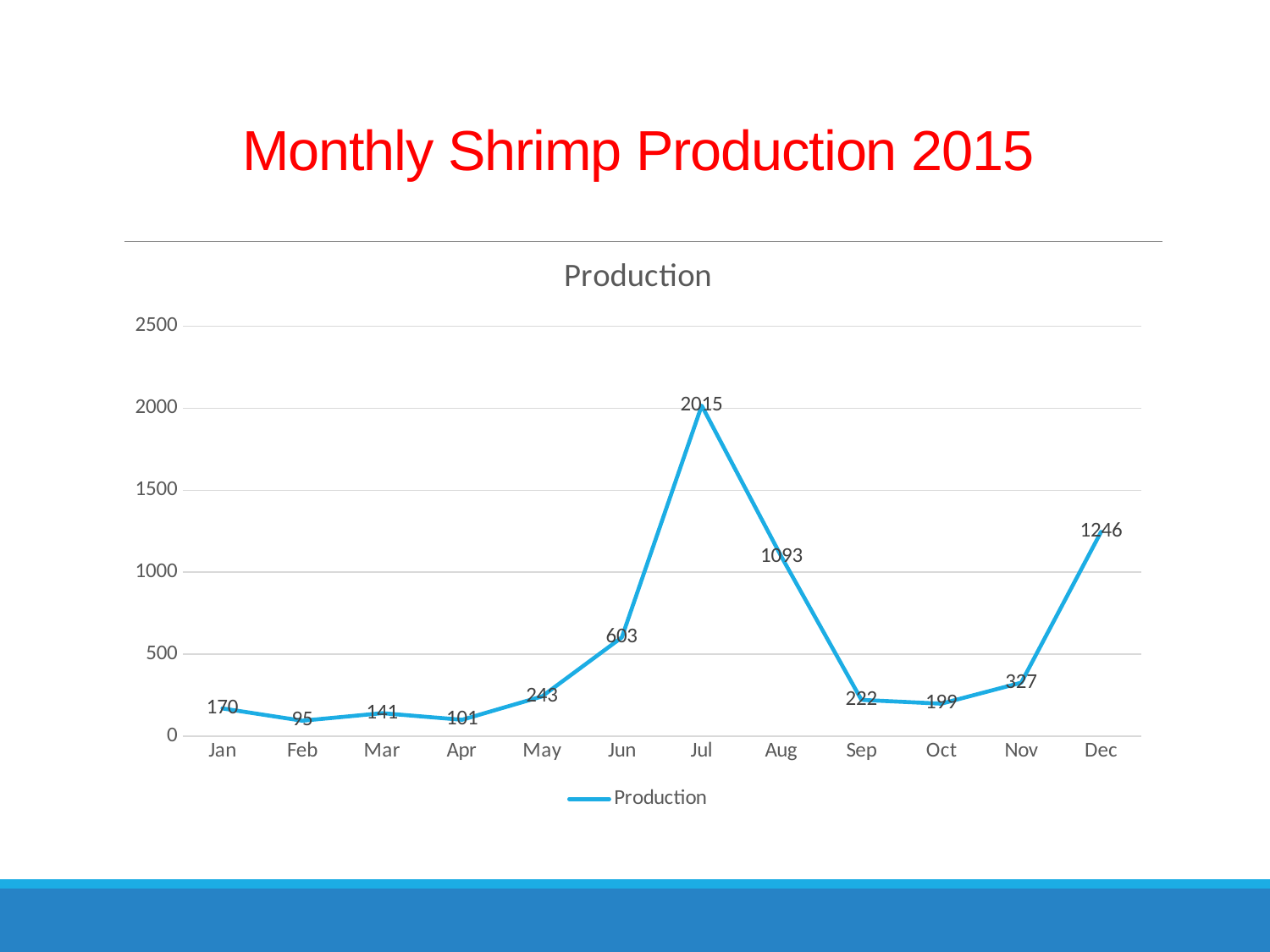
What is the difference between the production in July and in August? 922 What kind of chart is shown on the slide? line chart What is the production value for December? 1246 Which month has the lowest production? Feb How many months are plotted on the x axis? 12 How many series does the legend list? 1 What is the production value for February? 95 Which month has higher production, June or November? Jun What is the production value for July? 2015 Is the production value for August greater or less than 1000? greater Which month has the highest production? Jul Does production rise or fall from September to December? rise